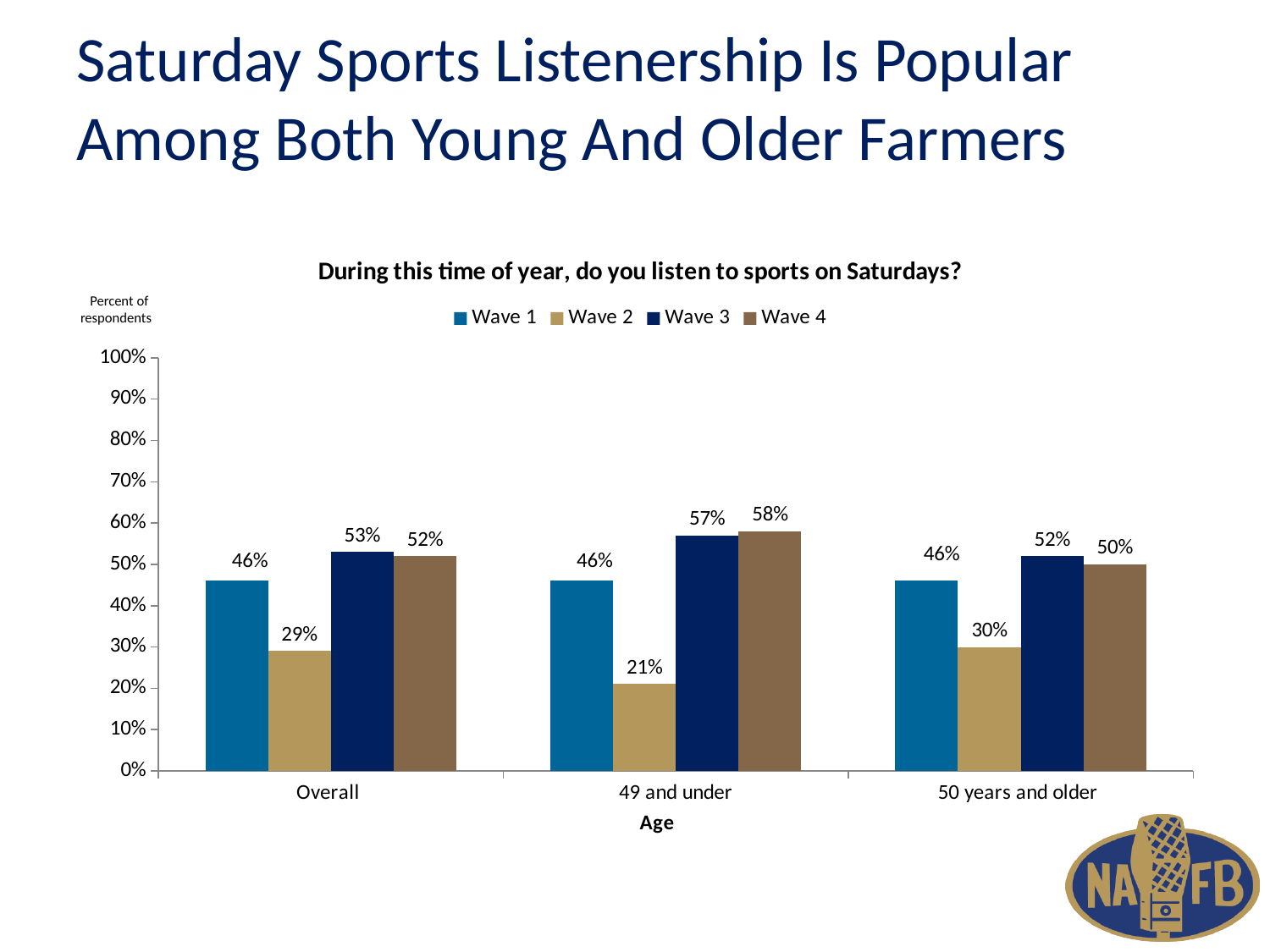
Which age category has the highest Wave 4 value? 49 and under What is the label of the x axis? Age What is the Wave 3 value for the 50 years and older group? 52% How many series does the legend list? 4 Which age category has the lowest Wave 2 value? 49 and under What is the difference between the Wave 3 and Wave 2 values for the 49 and under group? 36 percentage points Which is larger for the 50 years and older group: the Wave 1 value or the Wave 3 value? Wave 3 What is the Wave 4 value for the Overall category? 52% What kind of chart is shown on the slide? Bar chart What is the Wave 2 value for the 49 and under group? 21% How many age categories are shown on the x axis? 3 What is the title of the chart? During this time of year, do you listen to sports on Saturdays?